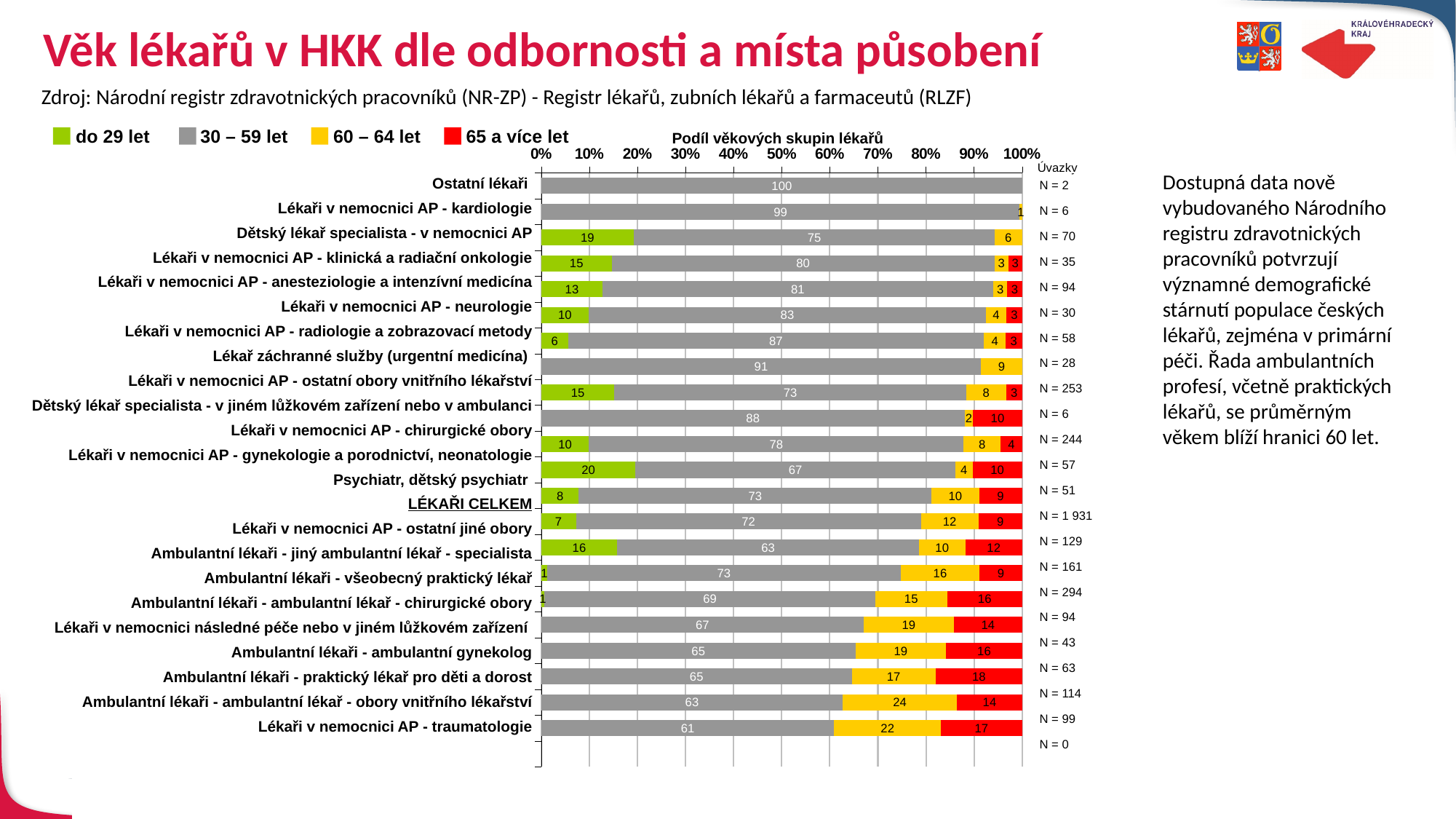
What is the share of the do 29 let age group for Dětský lékař specialista - v nemocnici AP? 19 What is the share of the do 29 let age group for Lékaři v nemocnici AP - radiologie a zobrazovací metody? 6 Which has a larger do 29 let share: Dětský lékař specialista - v nemocnici AP or Lékaři v nemocnici AP - neurologie? Dětský lékař specialista - v nemocnici AP What colour represents the 65 a více let age group in the legend? Red What is the Úvazky (N) value shown for Ostatní lékaři? N = 2 What is the difference between the 30 – 59 let share for Lékaři v nemocnici AP - neurologie and for Lékaři v nemocnici AP - klinická a radiační onkologie? 3 How many age groups does the legend list? 4 What kind of chart is shown on the slide? Stacked bar chart What is the share of the 30 – 59 let age group for Lékaři v nemocnici AP - anesteziologie a intenzívní medicína? 81 What is the share of the 30 – 59 let age group for Ostatní lékaři? 100 What is the title of the chart? Podíl věkových skupin lékařů What is the share of the 30 – 59 let age group for Lékaři v nemocnici AP - kardiologie? 99